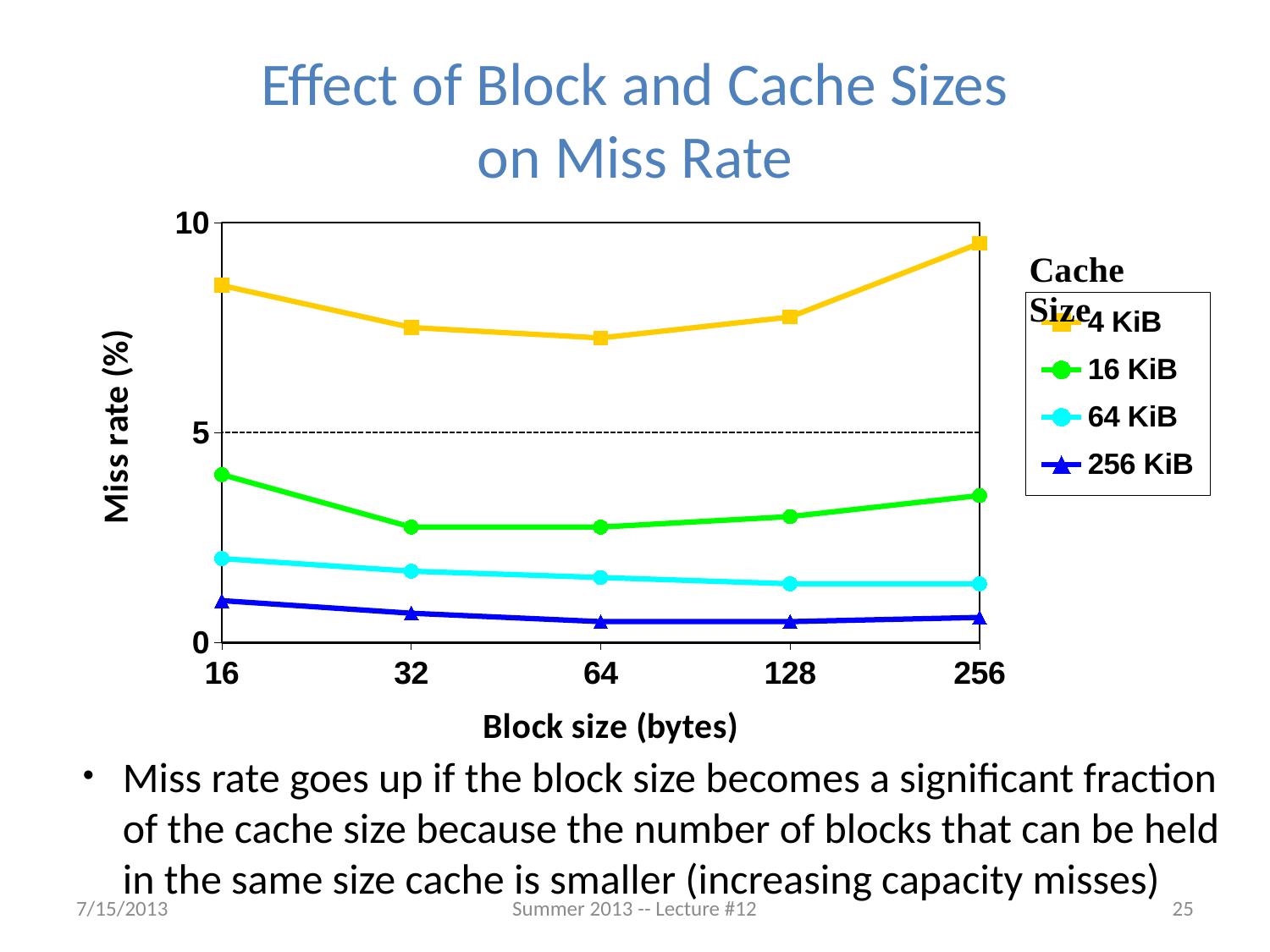
At block size 64, which has the higher miss rate, the 4 KiB cache or the 16 KiB cache? 4 KiB Is the miss rate for the 256 KiB cache at block size 16 greater or less than 5? less Which cache size has the lowest miss rate at block size 16? 256 KiB For the 64 KiB cache, does the miss rate rise or fall as block size increases from 16 to 256? fall How many series does the legend list? 4 What is the title of the x axis? Block size (bytes) Is the miss rate for the 4 KiB cache at block size 256 greater or less than 5? greater Which cache size has the highest miss rate at block size 256? 4 KiB Is the miss rate for the 16 KiB cache at block size 16 greater or less than 5? less What kind of chart is shown on the slide? line chart How many block sizes are plotted along the x axis? 5 For the 4 KiB cache, does the miss rate rise or fall from block size 128 to block size 256? rise